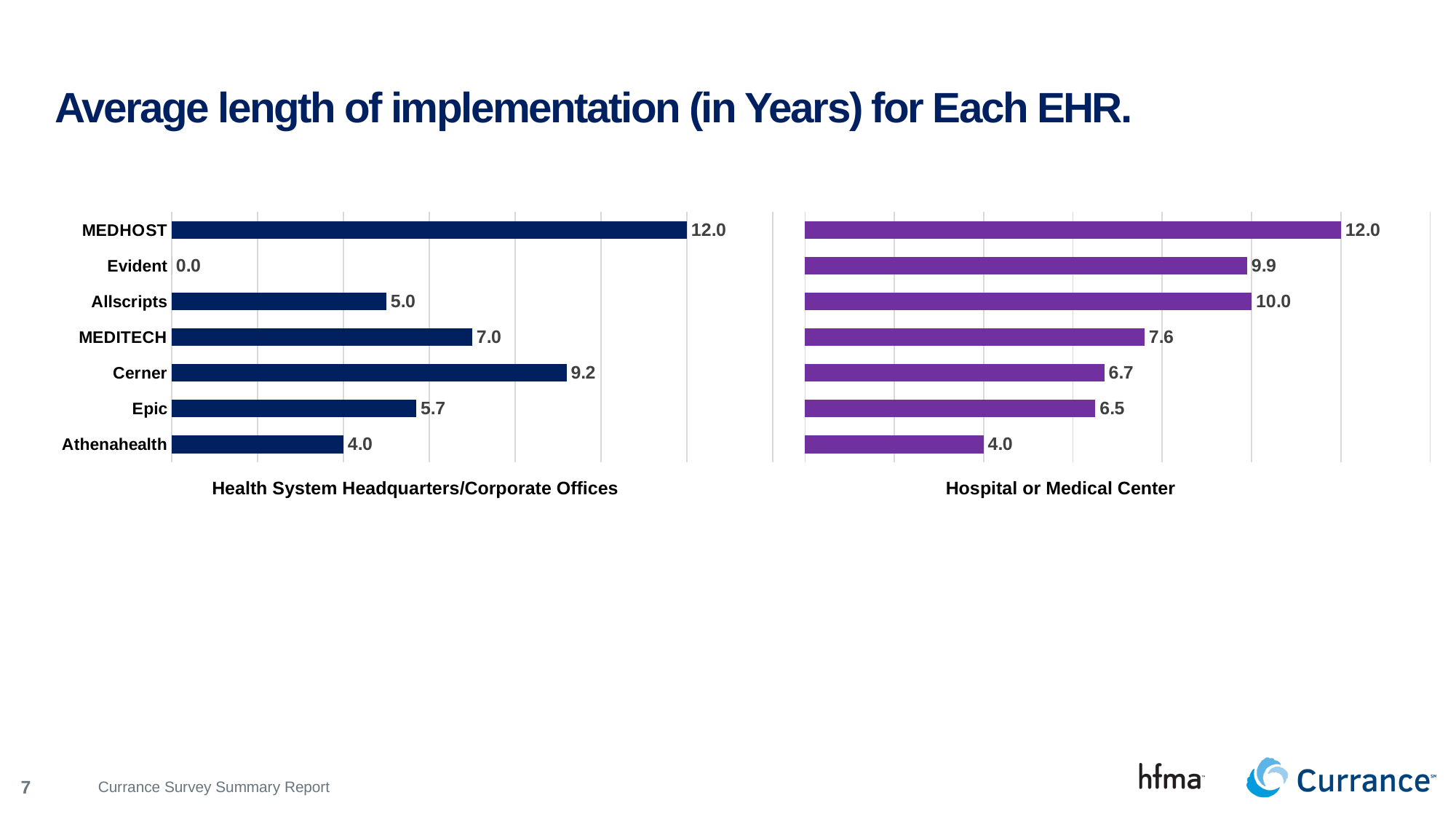
What is the title of the slide? Average length of implementation (in Years) for Each EHR. In the Hospital or Medical Center chart, which EHR has the lowest value? Athenahealth In the Hospital or Medical Center chart, what is the difference between the values for Allscripts and Athenahealth? 6.0 In the Hospital or Medical Center chart, what is the value for MEDITECH? 7.6 What kind of chart is the Hospital or Medical Center chart? Bar chart In the Hospital or Medical Center chart, which EHR has the highest value? MEDHOST In the Health System Headquarters/Corporate Offices chart, what is the difference between the values for Cerner and Epic? 3.5 In the Health System Headquarters/Corporate Offices chart, which is larger, the value for MEDITECH or the value for Allscripts? MEDITECH How many EHR categories are shown in the Health System Headquarters/Corporate Offices chart? 7 In the Health System Headquarters/Corporate Offices chart, what is the value for Cerner? 9.2 In the Health System Headquarters/Corporate Offices chart, which EHR has the lowest value? Evident In the Hospital or Medical Center chart, what is the value for Evident? 9.9